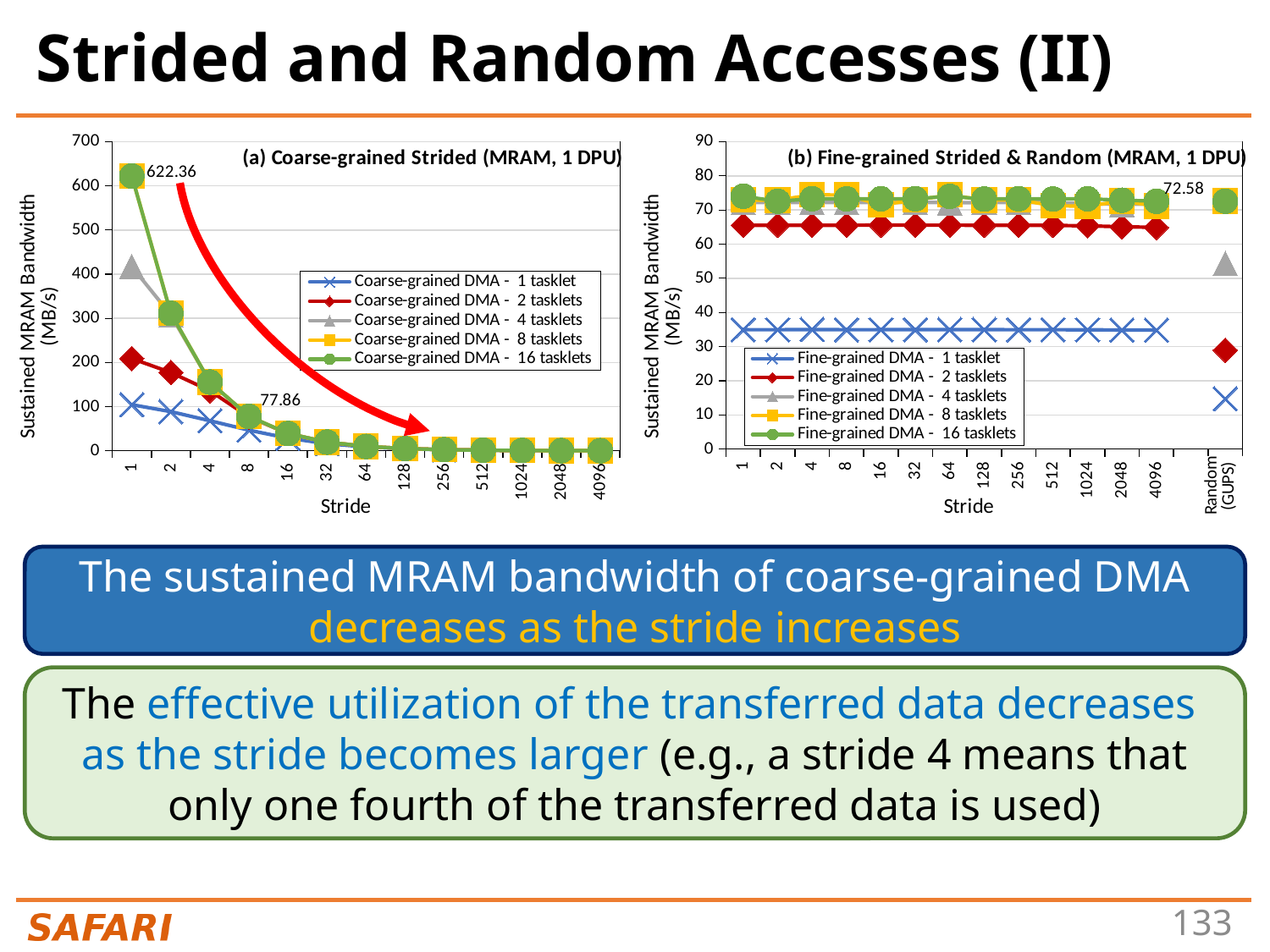
What type of chart is chart (a) Coarse-grained Strided (MRAM, 1 DPU)? Line chart How many stride values are shown on the x axis of chart (a) Coarse-grained Strided? 13 In chart (b) Fine-grained Strided & Random, what is the labeled bandwidth value at stride 4096? 72.58 In chart (a) Coarse-grained Strided, what is the labeled bandwidth value at stride 1? 622.36 In chart (a) Coarse-grained Strided, does the sustained MRAM bandwidth rise or fall as the stride increases? Fall In chart (a) Coarse-grained Strided, which series has the lowest value at stride 1? Coarse-grained DMA - 1 tasklet In chart (b) Fine-grained Strided & Random, is the value for Fine-grained DMA - 2 tasklets at stride 1 greater or less than 60? greater How many series does the legend of chart (b) Fine-grained Strided & Random list? 5 In chart (b) Fine-grained Strided & Random, which series has the lowest value at Random (GUPS)? Fine-grained DMA - 1 tasklet In chart (a) Coarse-grained Strided, is the value for Coarse-grained DMA - 1 tasklet at stride 1 greater or less than 200? less How many categories are shown on the x axis of chart (b) Fine-grained Strided & Random, including Random (GUPS)? 14 How many series does the legend of chart (a) Coarse-grained Strided list? 5